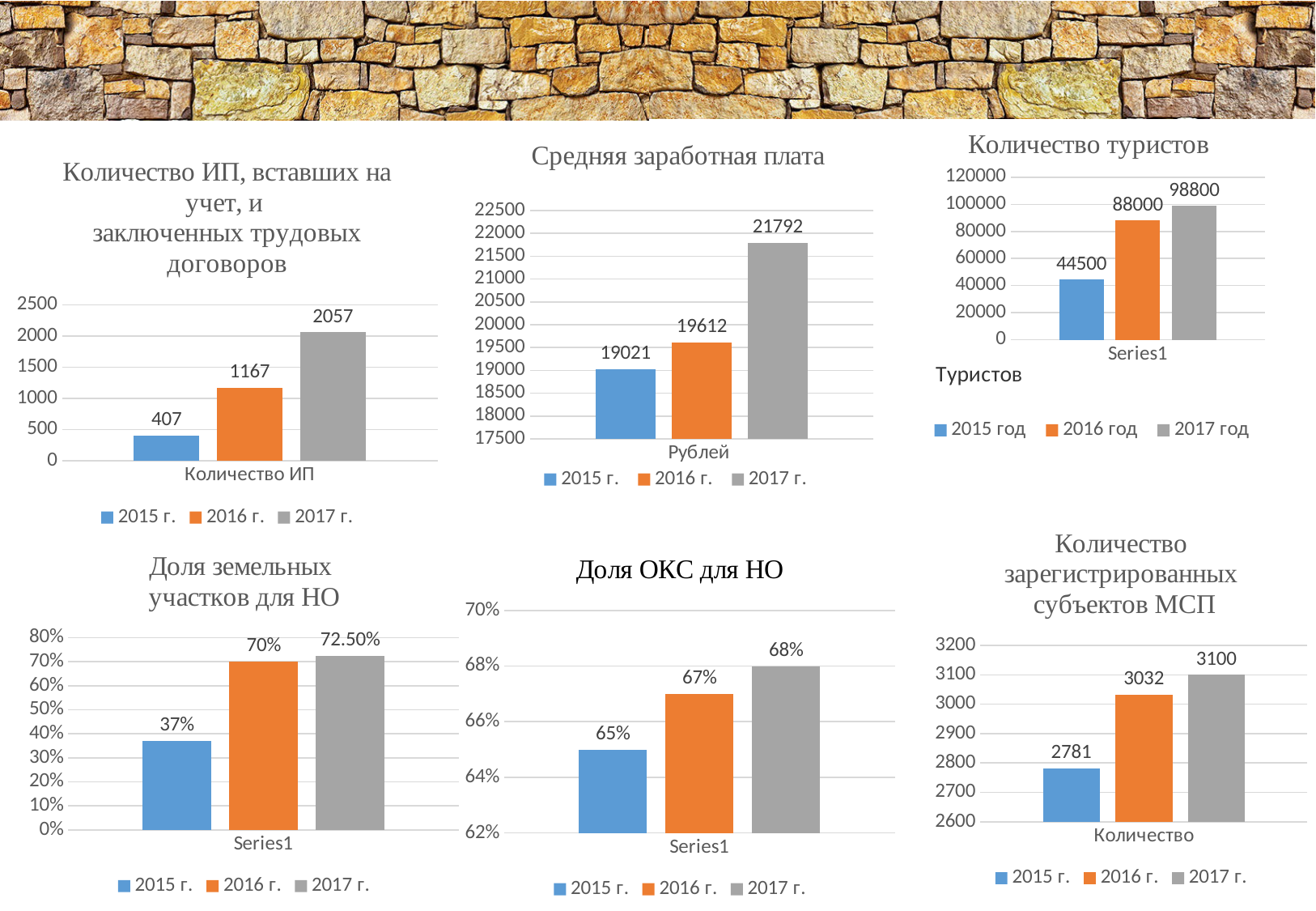
In the chart titled "Количество туристов", what is the value for 2015 год? 44500 In the chart titled "Доля земельных участков для НО", what is the value for 2017 г.? 72.50% In the chart titled "Количество ИП, вставших на учет, и заключенных трудовых договоров", which year has the lowest value? 2015 г. In the chart titled "Количество туристов", what is the difference between the 2016 год and 2015 год values? 43500 In the chart titled "Средняя заработная плата", which is larger, the value for 2015 г. or 2016 г.? 2016 г. In the chart titled "Количество ИП, вставших на учет, и заключенных трудовых договоров", do the values rise or fall from 2015 г. to 2017 г.? rise In the chart titled "Количество зарегистрированных субъектов МСП", what is the value for 2016 г.? 3032 In the chart titled "Средняя заработная плата", what is the value for 2017 г.? 21792 What kind of chart is the chart titled "Количество туристов"? bar chart In the chart titled "Доля ОКС для НО", what is the difference between the 2017 г. and 2015 г. values? 3% How many series does the legend list in the chart titled "Доля ОКС для НО"? 3 In the chart titled "Количество зарегистрированных субъектов МСП", which year has the highest value? 2017 г.